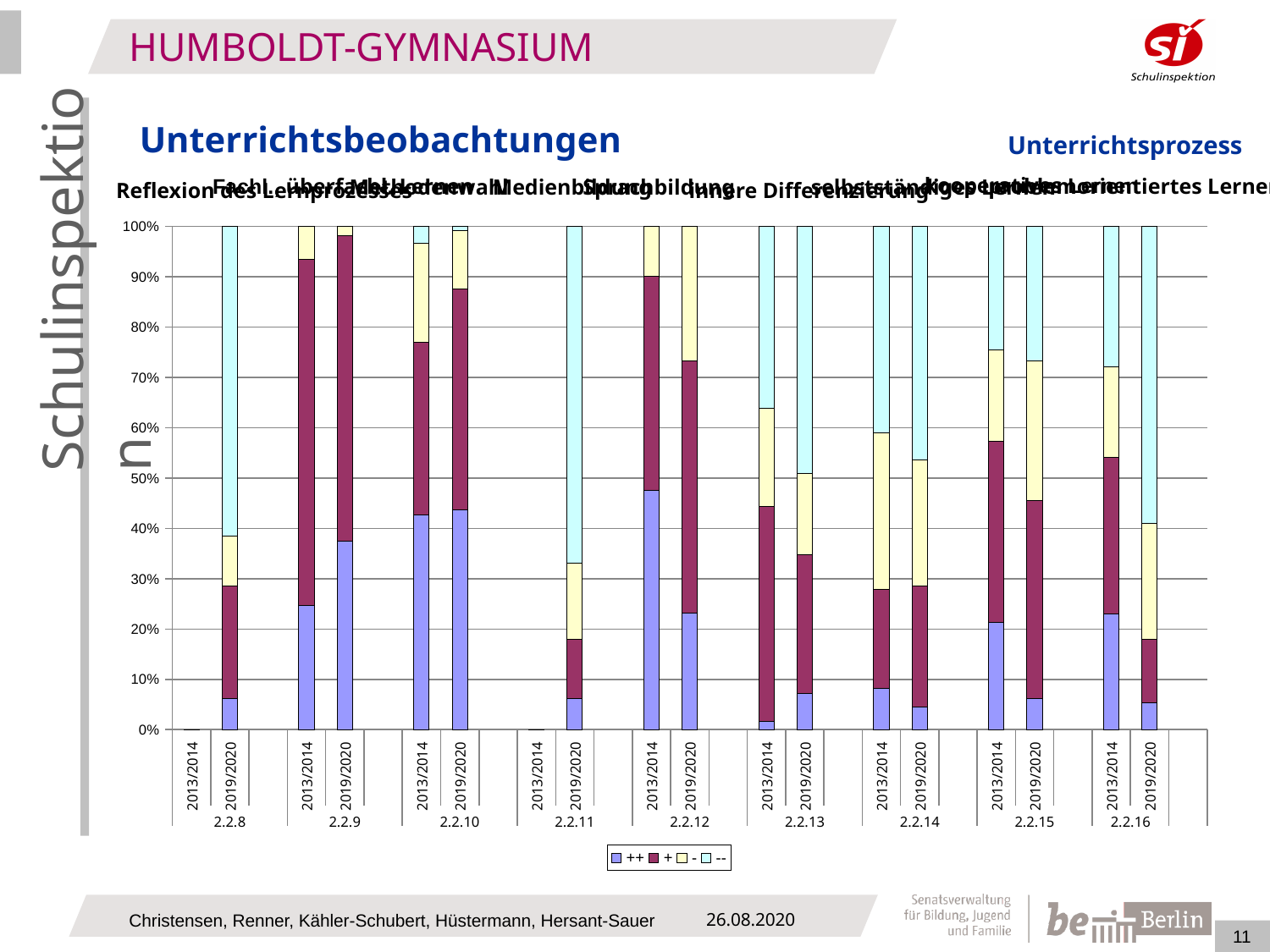
Is the '++' share for 2.2.9 in 2019/2020 greater or less than 30%? greater Is the '++' share for 2.2.16 in 2019/2020 greater or less than 10%? less For category 2.2.9, which year has the larger '++' share, 2013/2014 or 2019/2020? 2019/2020 What kind of chart is shown on the slide? stacked bar chart Among the 2013/2014 bars, which category has the highest '++' share? 2.2.12 Which two school years are compared for each category on the x axis? 2013/2014 and 2019/2020 Is the '++' share for 2.2.12 in 2013/2014 greater or less than 40%? greater How many numbered categories (2.2.x) are shown along the x axis? 9 For category 2.2.12, which year has the larger '++' share, 2013/2014 or 2019/2020? 2013/2014 What are the four legend entries of the chart? ++, +, -, -- How many series does the legend list? 4